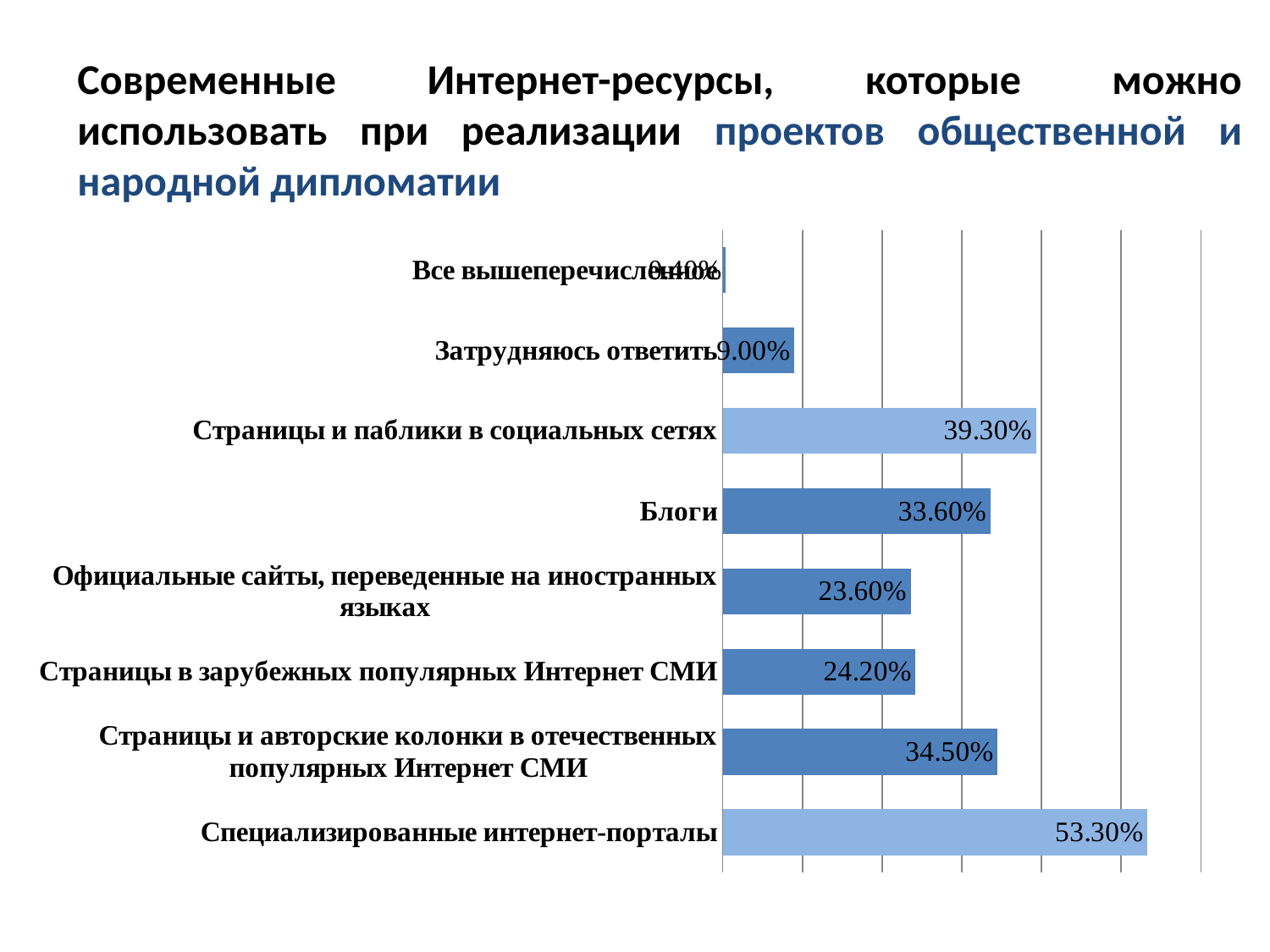
What is the value for Официальные сайты, переведенные на иностранных языках? 23.60% What is the difference between the values for Специализированные интернет-порталы and Страницы и паблики в социальных сетях? 14.00% Which category has the highest value? Специализированные интернет-порталы What is the value for Блоги? 33.60% What is the value for Затрудняюсь ответить? 9.00% What kind of chart is shown on the slide? Bar chart What is the value for Специализированные интернет-порталы? 53.30% Which category has the lowest value? Все вышеперечисленное How many categories are shown in the chart? 8 Which is larger: the value for Страницы и авторские колонки в отечественных популярных Интернет СМИ or the value for Блоги? Страницы и авторские колонки в отечественных популярных Интернет СМИ What is the difference between the values for Страницы в зарубежных популярных Интернет СМИ and Официальные сайты, переведенные на иностранных языках? 0.60% What is the value for Страницы и паблики в социальных сетях? 39.30%